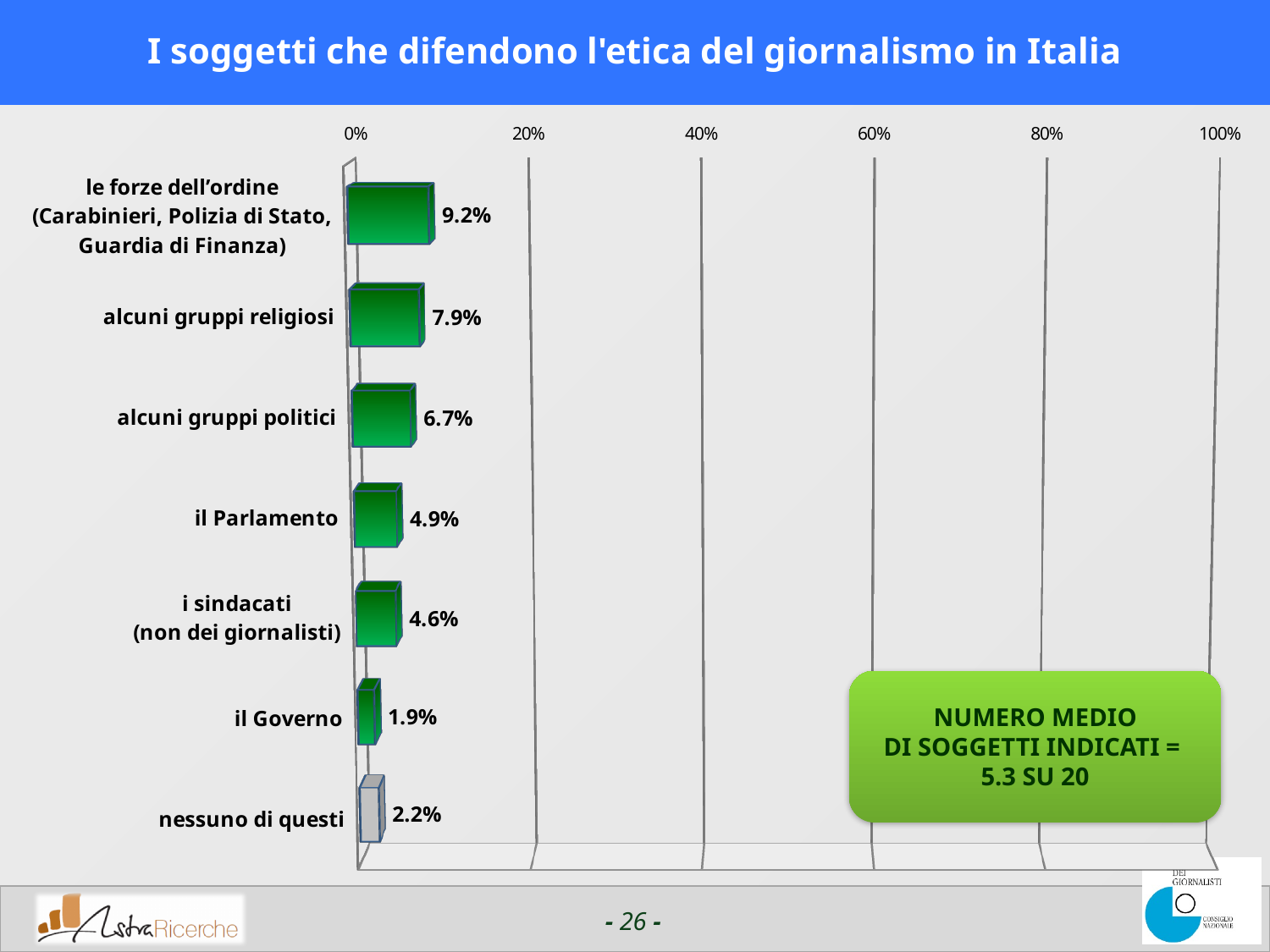
How many categories are shown in the chart? 7 What is the difference between the values for 'le forze dell'ordine' and 'alcuni gruppi politici'? 2.5% Which is larger, the value for 'i sindacati (non dei giornalisti)' or the value for 'nessuno di questi'? i sindacati (non dei giornalisti) What is the value for 'il Parlamento'? 4.9% Is the value for 'alcuni gruppi politici' greater or less than 20%? less What is the value for 'nessuno di questi'? 2.2% Which category has the highest value? le forze dell'ordine (Carabinieri, Polizia di Stato, Guardia di Finanza) What is the title of the slide? I soggetti che difendono l'etica del giornalismo in Italia What is the value for 'il Governo'? 1.9% What kind of chart is shown on the slide? bar chart What is the value for 'alcuni gruppi religiosi'? 7.9% Which category has the lowest value? il Governo